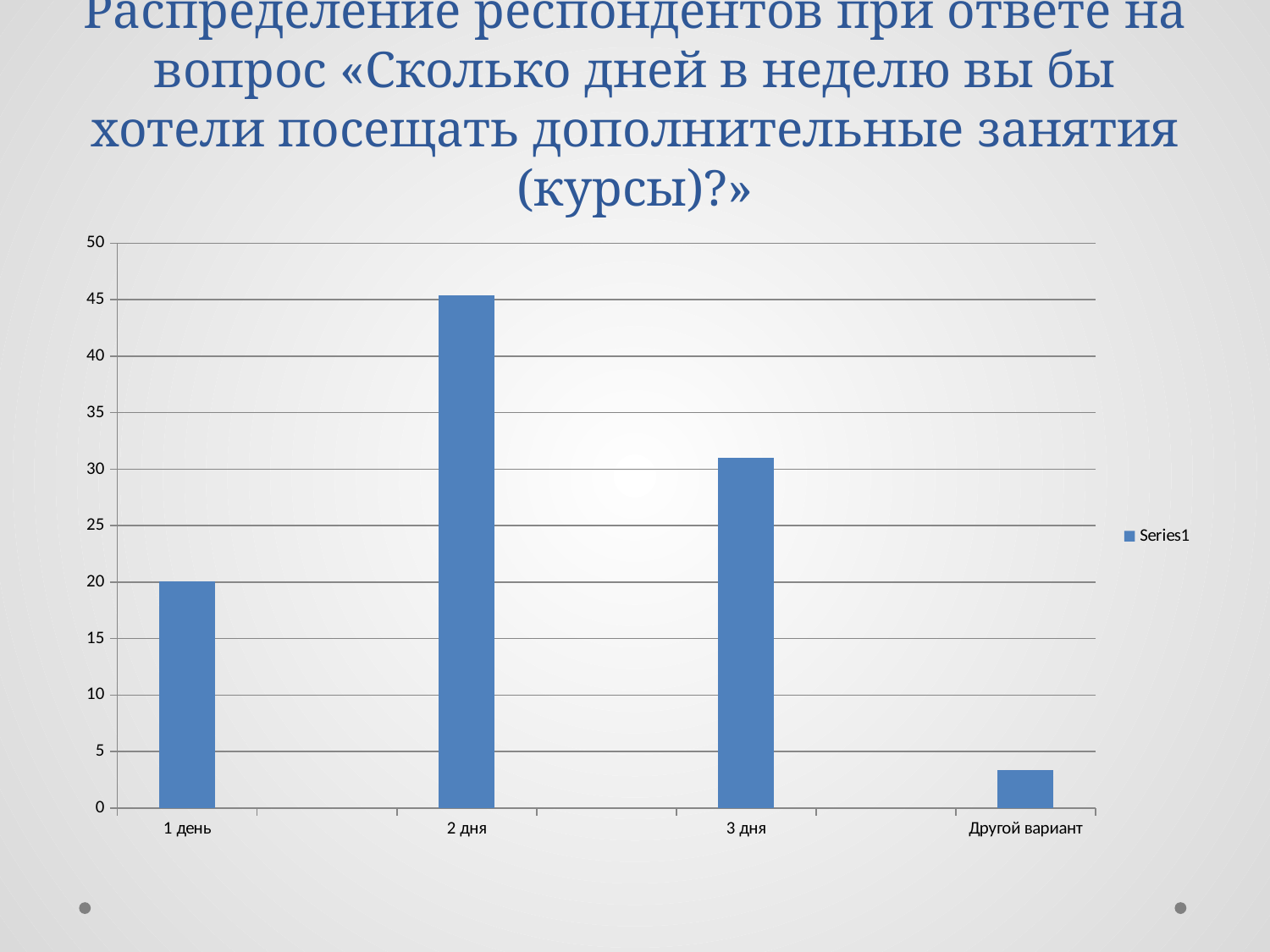
Which category has the highest bar? 2 дня Is the value for 3 дня greater or less than 35? less Which is larger, the value for 2 дня or the value for 3 дня? 2 дня Which is larger, the value for 3 дня or the value for 1 день? 3 дня Which category has the lowest bar? Другой вариант What is the name of the series shown in the legend? Series1 Is the value for 2 дня greater or less than 40? greater How many categories are shown on the x axis of the chart? 4 What kind of chart is shown on the slide? bar chart Is the value for Другой вариант greater or less than 5? less How many series does the legend list? 1